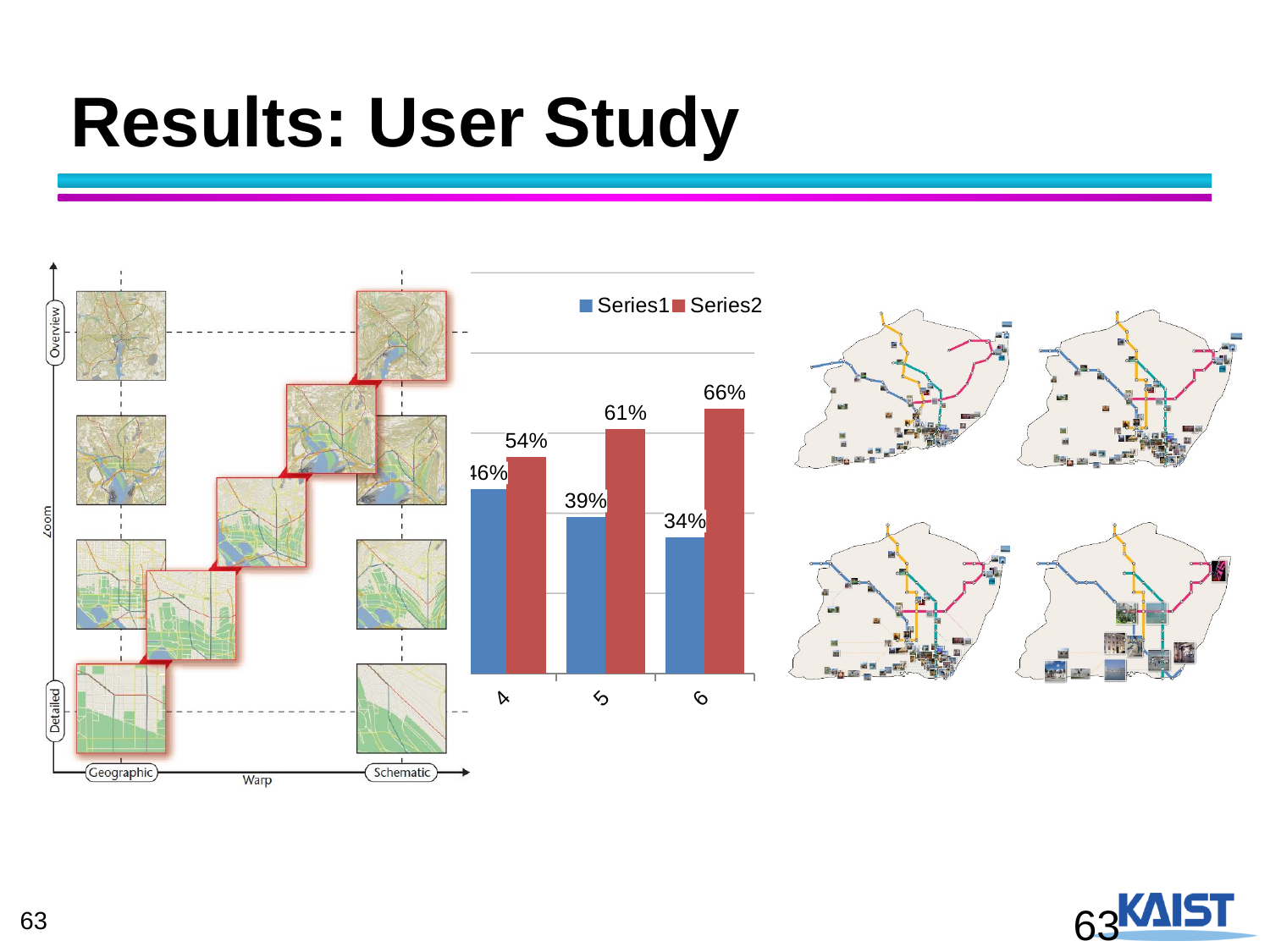
For which category is Series2 highest? 6 How many series does the legend list? 2 What is the value of Series2 for category 6? 66% What is the value of Series1 for category 5? 39% What is the value of Series2 for category 4? 54% What is the value of Series2 for category 5? 61% How many categories are shown on the x axis of the bar chart? 3 What is the value of Series1 for category 6? 34% What is the difference between Series2 and Series1 for category 6? 32% For category 5, which series has the larger value, Series1 or Series2? Series2 Do the Series1 values rise or fall from category 4 to category 6? fall For which category is Series1 lowest? 6